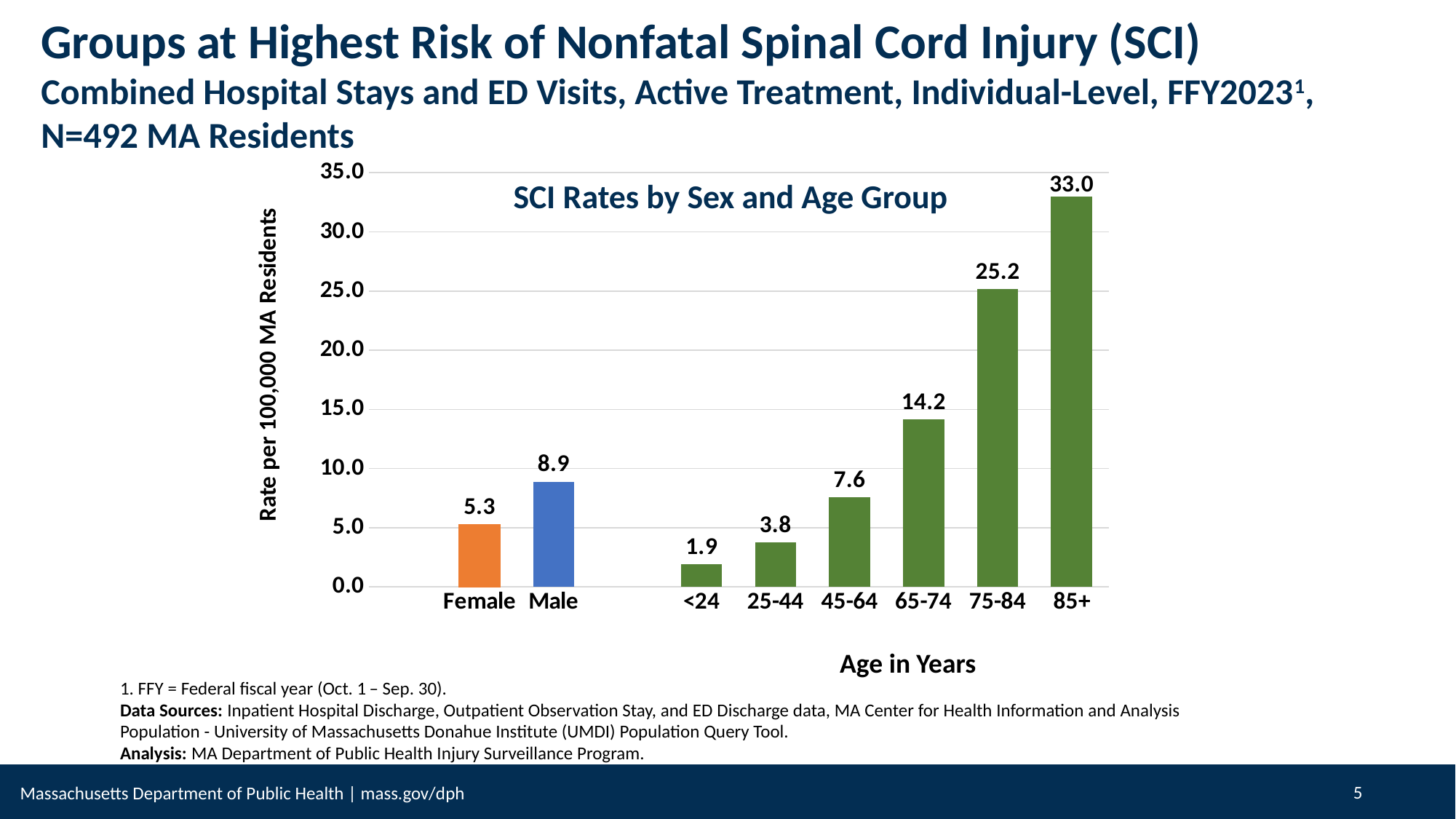
What is the difference between the SCI rates for the 85+ and 75-84 age groups? 7.8 What kind of chart is shown on the slide? Bar chart What is the difference between the Male and Female SCI rates? 3.6 Do the SCI rates rise or fall as age group increases along the x axis? Rise What is the SCI rate for the 45-64 age group? 7.6 Which age group has the highest SCI rate? 85+ What is the SCI rate for the 85+ age group? 33.0 How many age group categories are shown on the chart? 6 What is the title of the chart? SCI Rates by Sex and Age Group What is the SCI rate for Female? 5.3 Which age group has the lowest SCI rate? <24 Which has a higher SCI rate, Male or Female? Male